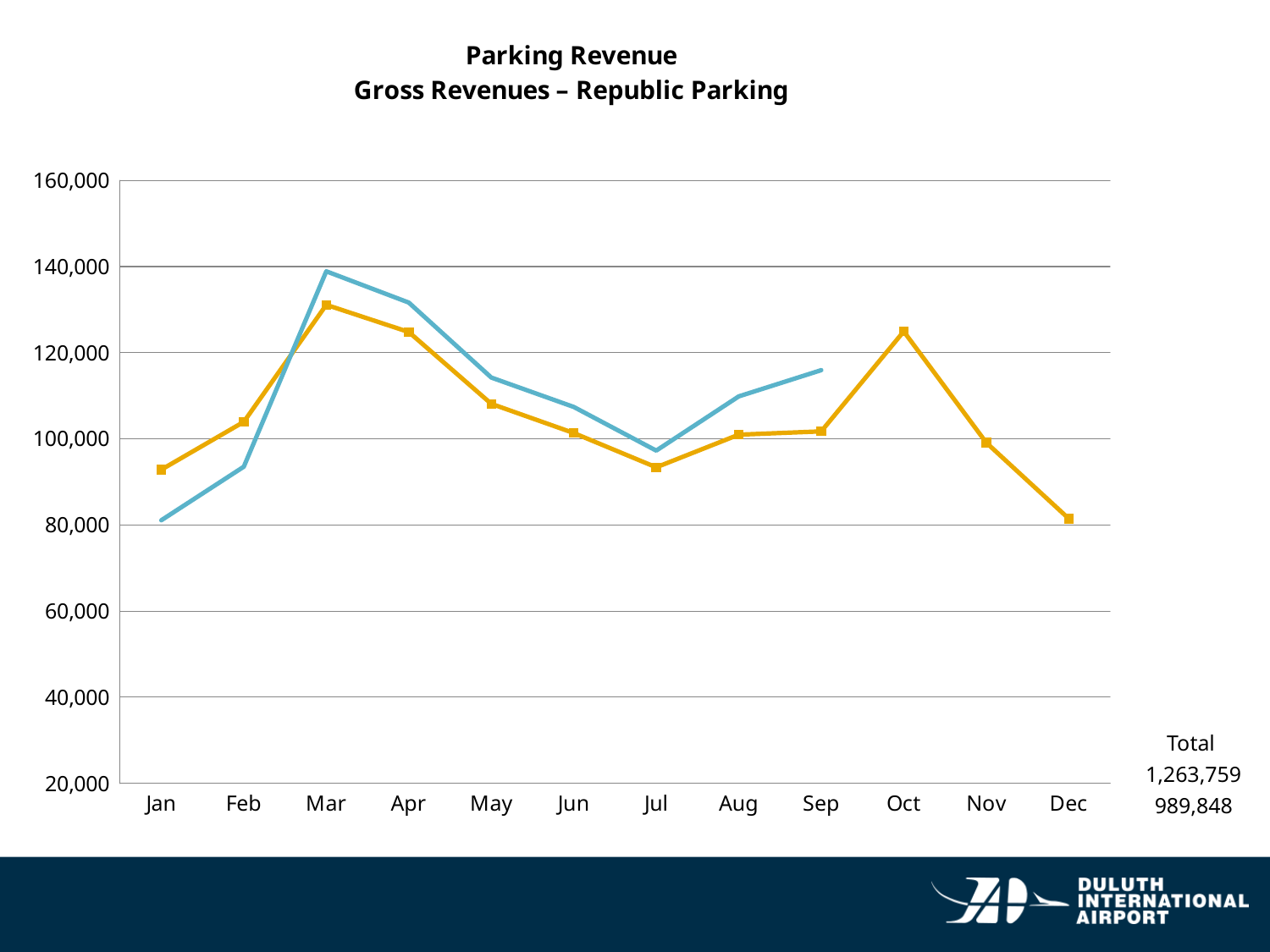
In which month does the orange line with square markers reach its lowest value? Dec What type of chart is shown on the slide? Line chart Is the value of the orange line in Jul greater or less than 100,000? less In which month does the orange line with square markers reach its highest value? Mar In Jan, which line is higher, the blue line or the orange line? Orange line How many months are shown on the x axis of the chart? 12 In which month does the blue line reach its highest value? Mar Does the orange line rise or fall from Oct to Dec? Fall In Mar, which line is higher, the blue line or the orange line? Blue line How many lines are plotted on the chart? 2 In which month does the blue line reach its lowest value? Jan Is the value of the orange line in Oct greater or less than 120,000? greater